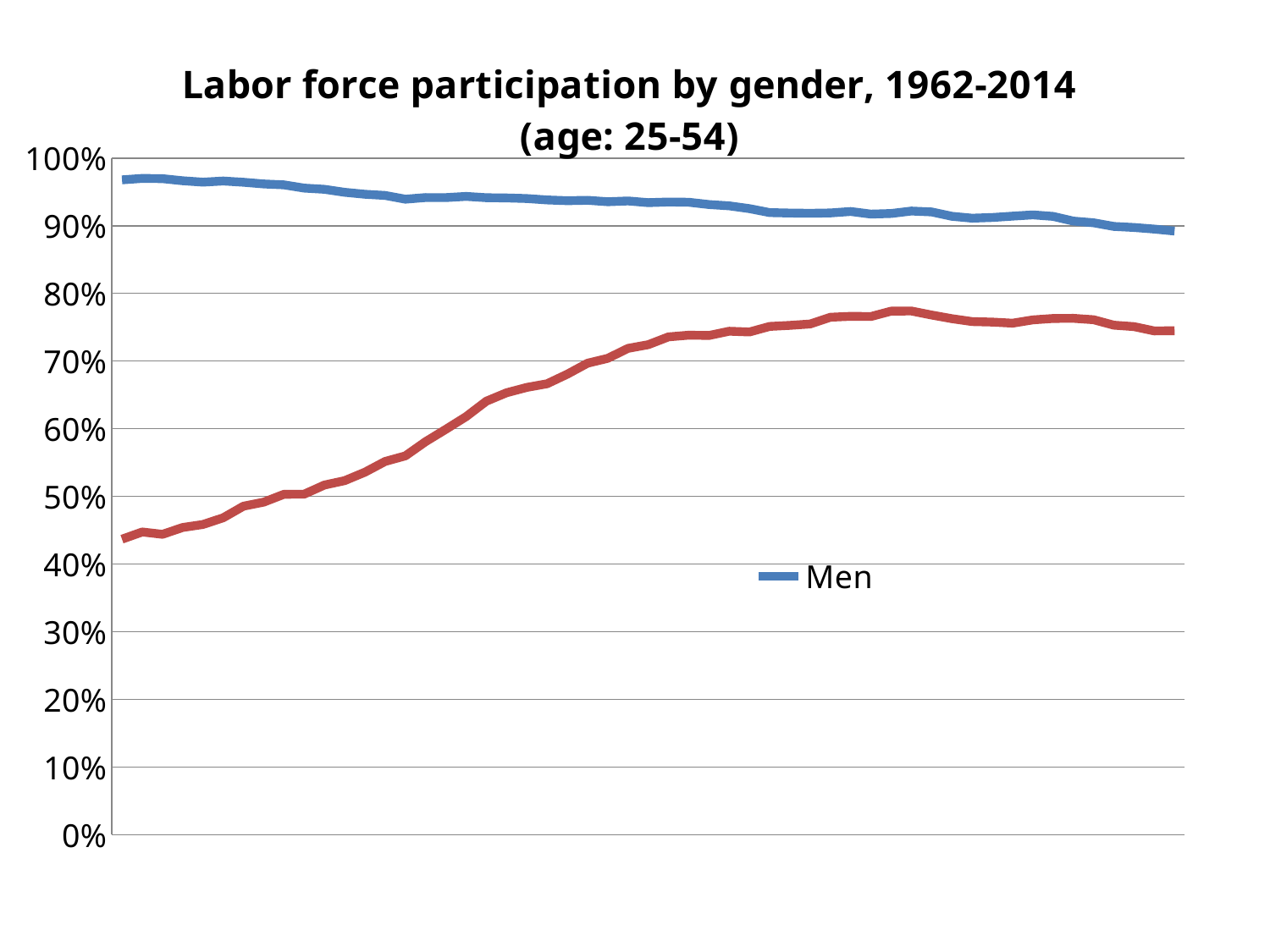
What kind of chart is shown on the slide? line chart How many series does the legend list? 1 What is the title of the chart? Labor force participation by gender, 1962-2014 (age: 25-54) Is the value of the Men line at the left end of the chart greater or less than 90%? greater Does the red line ever reach above 80% on the chart? no Which line is higher throughout the chart, the Men line or the red line? Men Is the value of the Men line at the right end of the chart greater or less than 80%? greater Which series is named in the legend? Men Does the red line rise or fall from left to right across the chart? rise Does the Men line rise or fall from left to right across the chart? fall